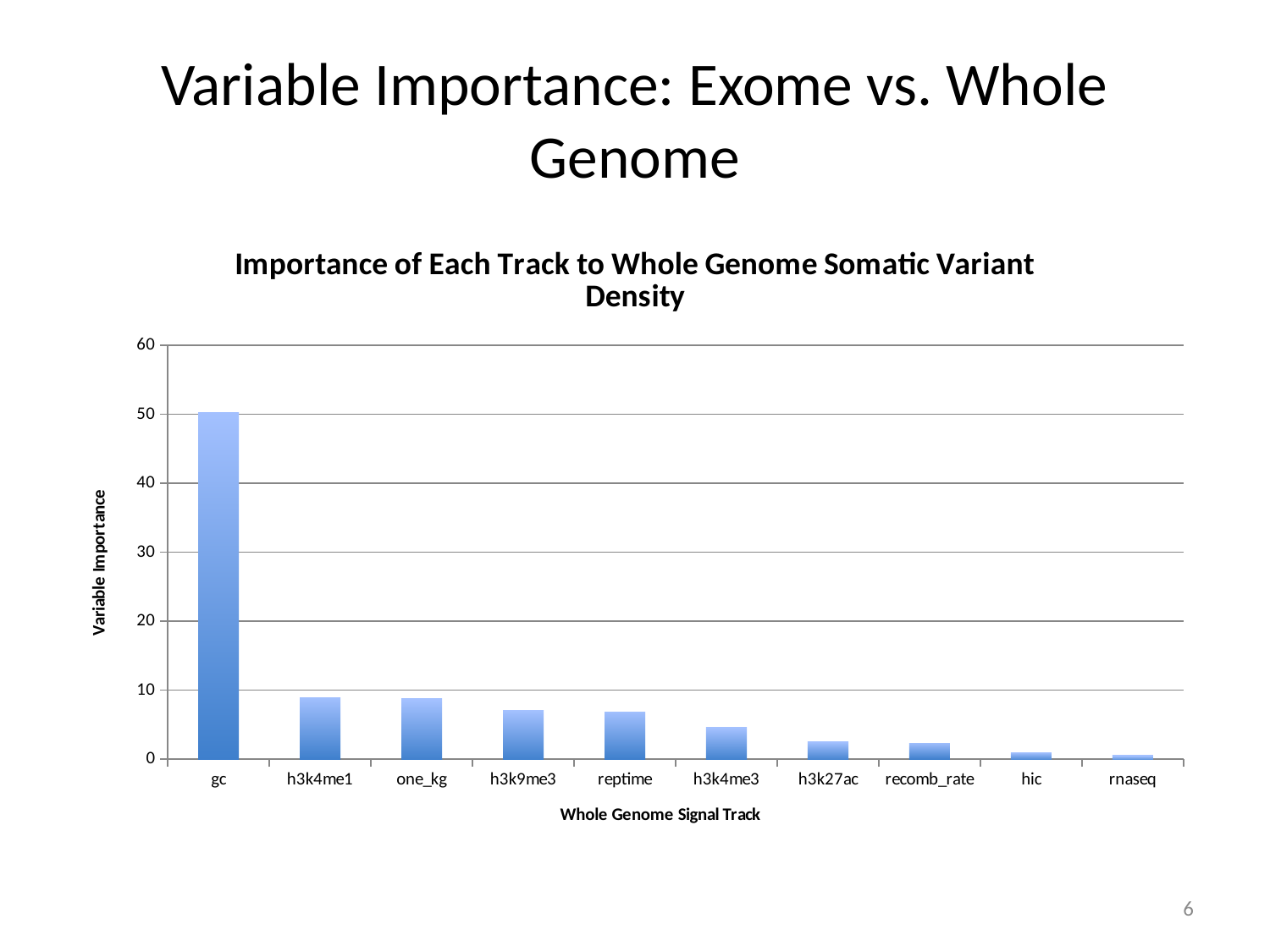
What is the title of the chart? Importance of Each Track to Whole Genome Somatic Variant Density What kind of chart is shown on the slide? bar chart Which has a larger variable importance, gc or h3k4me1? gc How many signal tracks are plotted on the x axis? 10 Is the value for h3k4me3 greater or less than 10? less Which has a larger variable importance, h3k4me3 or h3k27ac? h3k4me3 Is the value for gc greater or less than 40? greater Which track has the highest variable importance? gc Is the value for gc greater or less than 60? less Do the values rise or fall moving from left to right along the x axis? fall What is the label of the y axis? Variable Importance